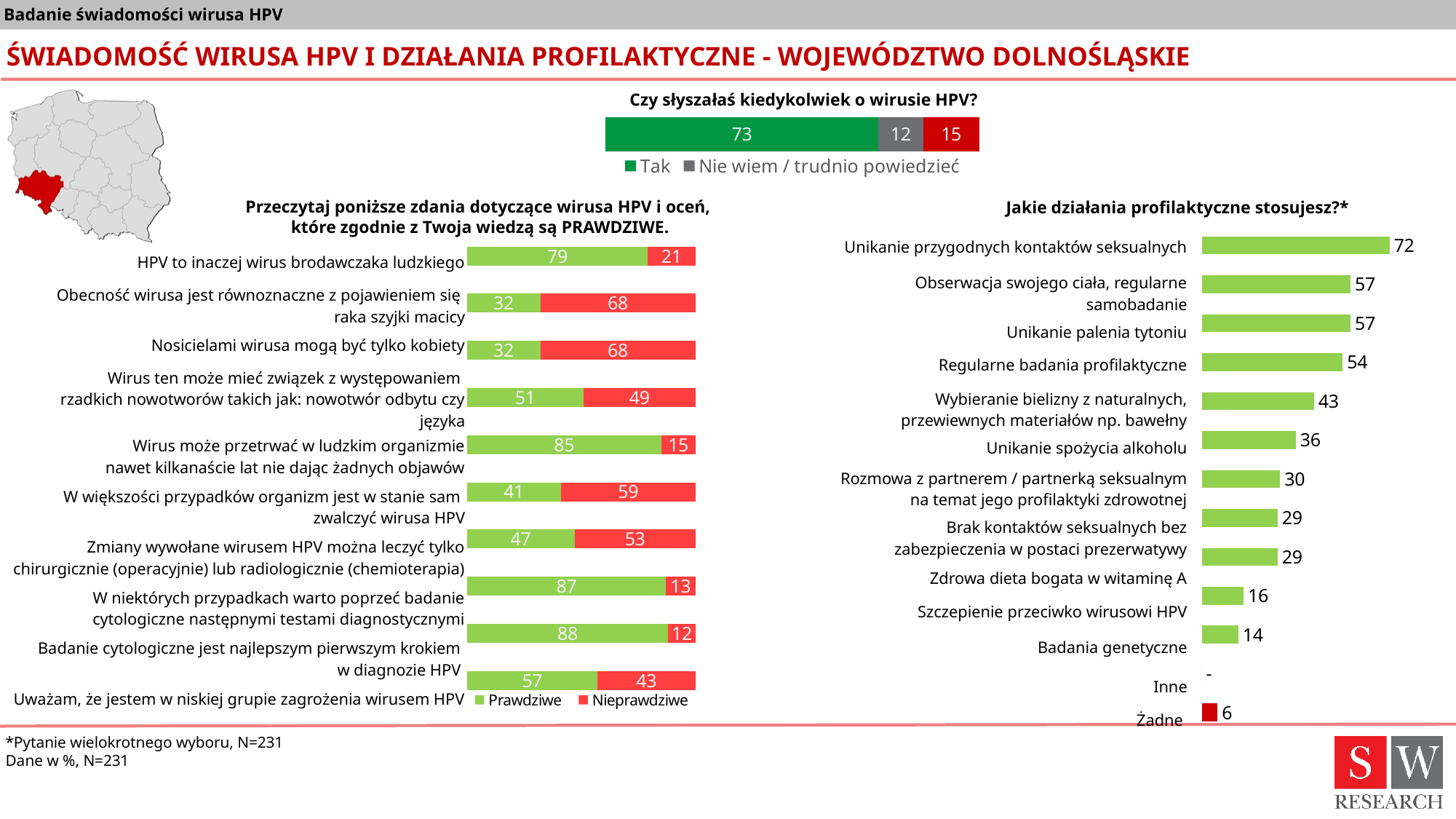
In the chart 'Jakie działania profilaktyczne stosujesz?', what is the difference between 'Unikanie przygodnych kontaktów seksualnych' and 'Unikanie spożycia alkoholu'? 36 In the chart 'Jakie działania profilaktyczne stosujesz?', what is the value for 'Szczepienie przeciwko wirusowi HPV'? 16 In the chart 'Przeczytaj poniższe zdania dotyczące wirusa HPV...', what is the 'Nieprawdziwe' value for 'Nosicielami wirusa mogą być tylko kobiety'? 68 In the chart 'Jakie działania profilaktyczne stosujesz?', what is the value for 'Żadne'? 6 In the chart 'Czy słyszałaś kiedykolwiek o wirusie HPV?', what is the value for 'Tak'? 73 In the chart 'Czy słyszałaś kiedykolwiek o wirusie HPV?', what is the value for 'Nie wiem / trudno powiedzieć'? 12 In the chart 'Przeczytaj poniższe zdania dotyczące wirusa HPV...', what is the 'Prawdziwe' value for 'HPV to inaczej wirus brodawczaka ludzkiego'? 79 What kind of chart is 'Jakie działania profilaktyczne stosujesz?'? Bar chart In the chart 'Jakie działania profilaktyczne stosujesz?', which is larger: 'Unikanie palenia tytoniu' or 'Wybieranie bielizny z naturalnych, przewiewnych materiałów np. bawełny'? Unikanie palenia tytoniu In the chart 'Jakie działania profilaktyczne stosujesz?', which category has the highest value? Unikanie przygodnych kontaktów seksualnych In the chart 'Przeczytaj poniższe zdania dotyczące wirusa HPV...', how many series does the legend list? 2 In the chart 'Jakie działania profilaktyczne stosujesz?', what is the value for 'Regularne badania profilaktyczne'? 54